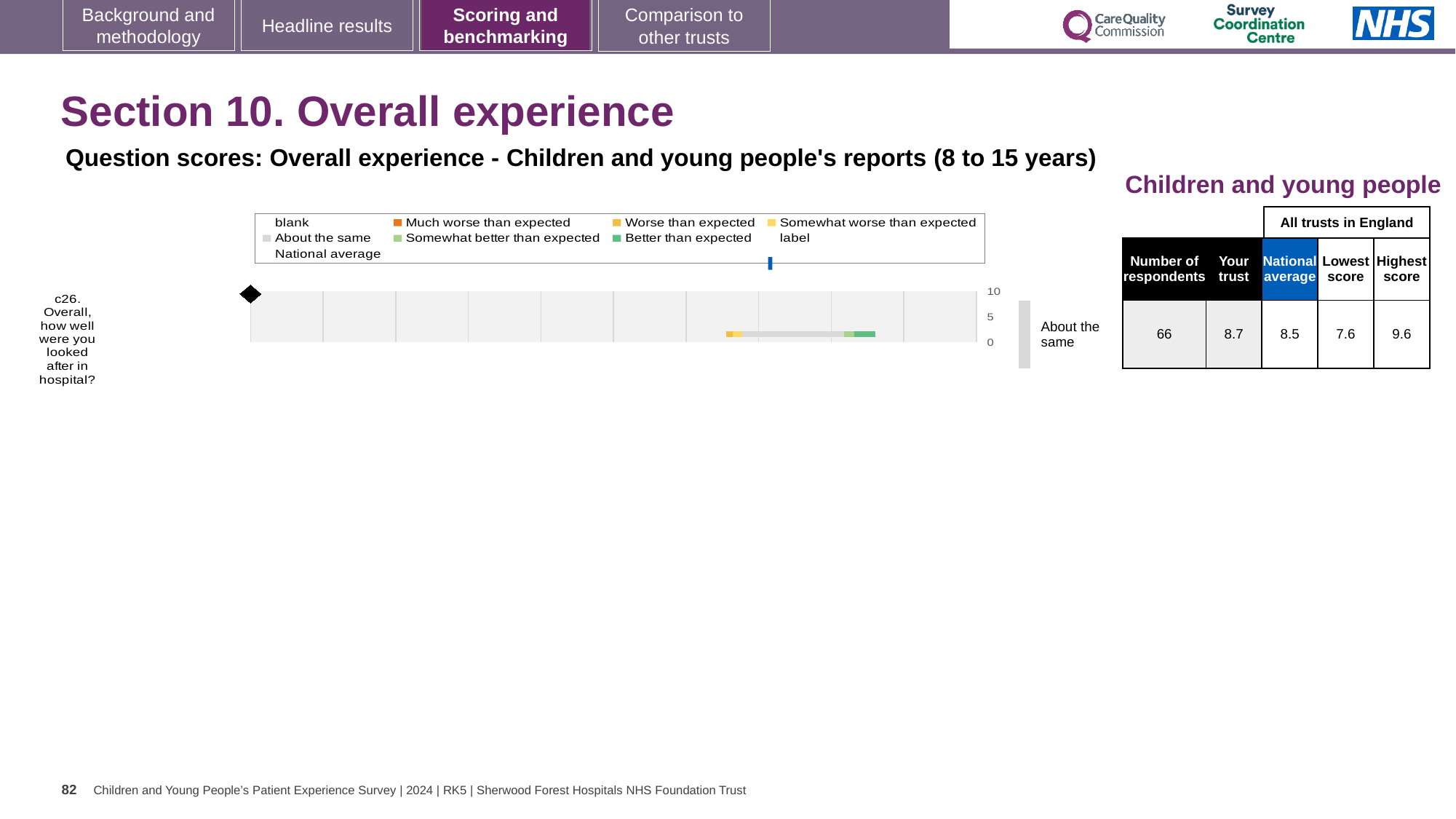
In the table beside the chart, what is the highest score among all trusts in England for question c26? 9.6 How many questions (categories) are plotted on the chart? 1 What is the difference between the highest score and the lowest score among all trusts in England for question c26? 2.0 What is the highest value shown on the chart's score axis? 10 How many entries does the chart legend list? 9 What kind of chart is used to show the score for question c26? bar chart What benchmark category label is shown to the right of the bar for question c26? About the same In the table beside the chart, what is the national average score for question c26? 8.5 In the table beside the chart, what is the 'Your trust' score for question c26? 8.7 In the table beside the chart, what is the lowest score among all trusts in England for question c26? 7.6 Which is larger for question c26: the 'Your trust' score or the national average? Your trust In the table beside the chart, how many respondents answered question c26? 66